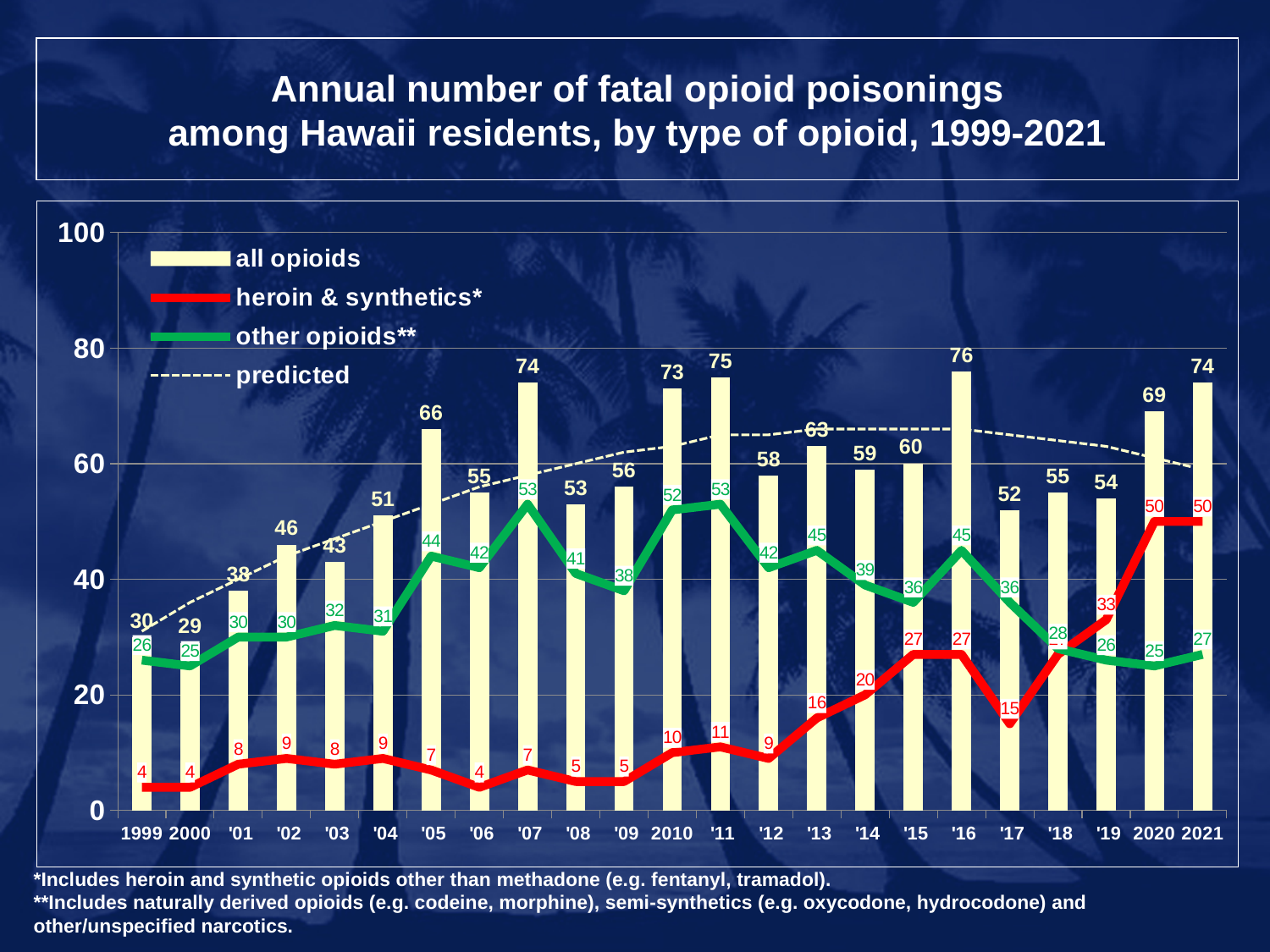
What is the value for all opioids in 2016? 76 What kind of chart is used for the all opioids series? bar chart Which is larger in 2013: the other opioids value or the heroin & synthetics value? other opioids What is the value for heroin & synthetics in 2021? 50 What is the value for other opioids in 2007? 53 Which legend entry is drawn as a dashed line? predicted What is the difference between the all opioids values for 2021 and 2020? 5 How many entries does the legend list? 4 In which year is the all opioids bar lowest? 2000 In which year is the all opioids bar highest? 2016 How many years are shown on the x axis? 23 Does the heroin & synthetics line rise or fall from 2017 to 2021? rise